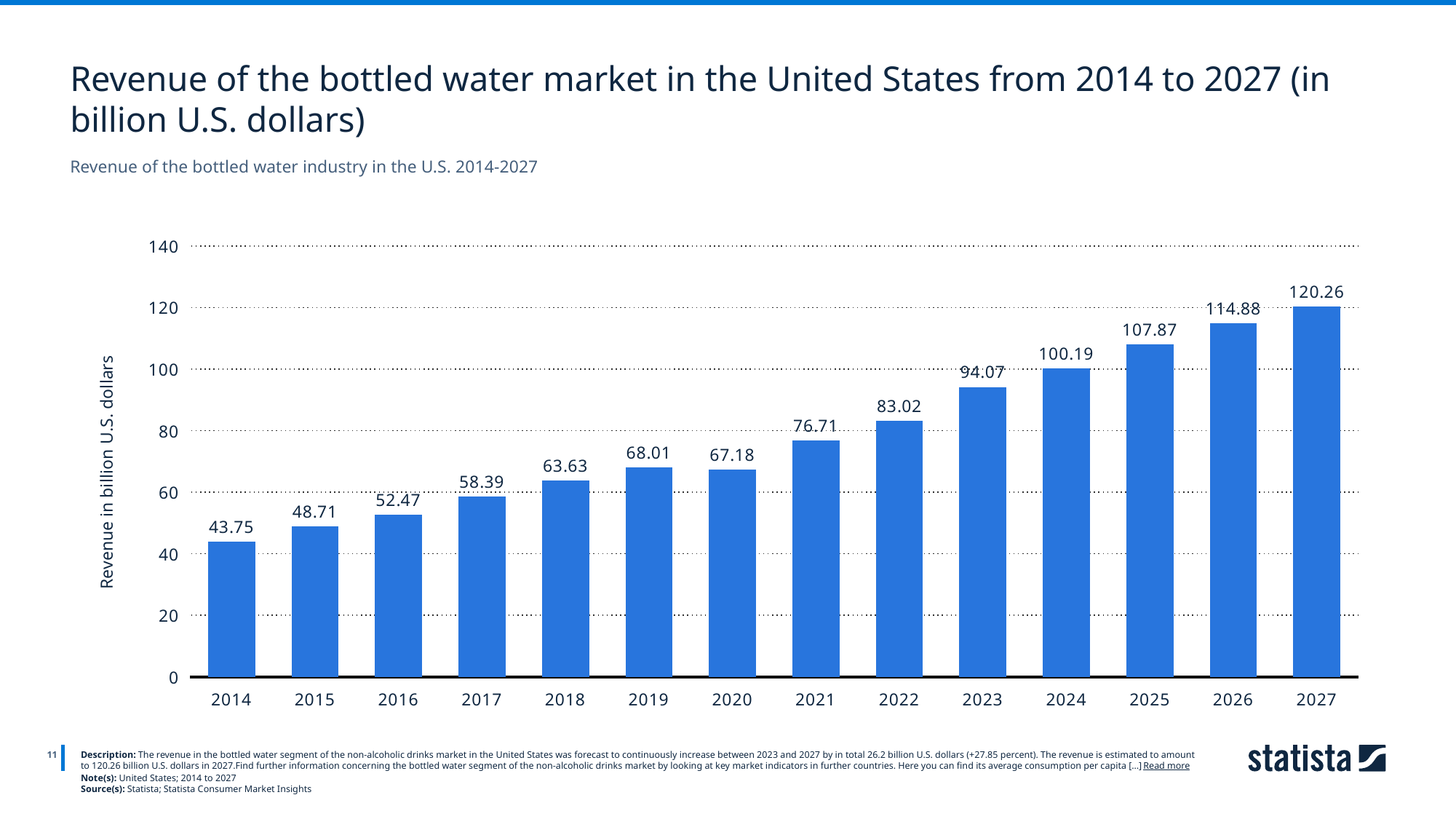
How many years are shown on the x axis? 14 Do the revenue values generally rise or fall from 2014 to 2027? Rise What is the revenue value shown for 2024? 100.19 Is the value for 2023 greater or less than 100? less Which year has the highest revenue? 2027 What is the difference between the revenue in 2027 and the revenue in 2026? 5.38 What is the label of the y axis? Revenue in billion U.S. dollars Which year has the lowest revenue? 2014 What kind of chart is shown on the slide? Bar chart Which year has the larger revenue, 2019 or 2020? 2019 What is the revenue of the bottled water market in the United States in 2014? 43.75 What is the revenue value shown for 2020? 67.18